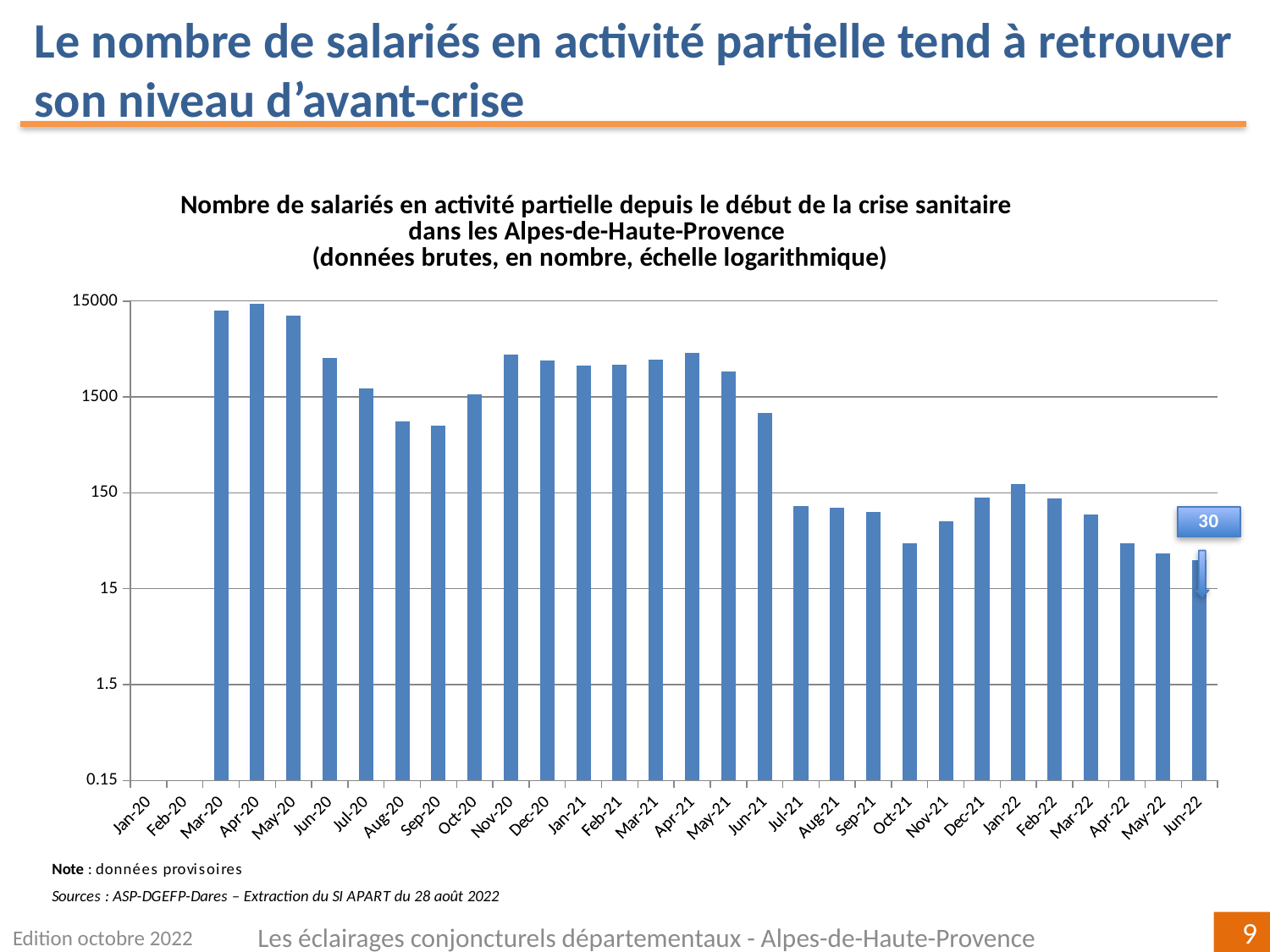
Overall, do the values rise or fall from Apr-20 to Jun-22? fall What kind of chart is shown on the slide? bar chart Is the value for Jun-21 greater or less than 150? greater What type of scale does the y axis of the chart use, according to the chart title? logarithmic (échelle logarithmique) Is the value for Oct-21 greater or less than 150? less Which is larger, the value for Jun-21 or the value for Jul-21? Jun-21 What is the value shown by the data label for Jun-22? 30 Which month has the highest bar in the chart? Apr-20 How many months are listed along the x axis? 30 Is the value for Nov-20 greater or less than 1500? greater